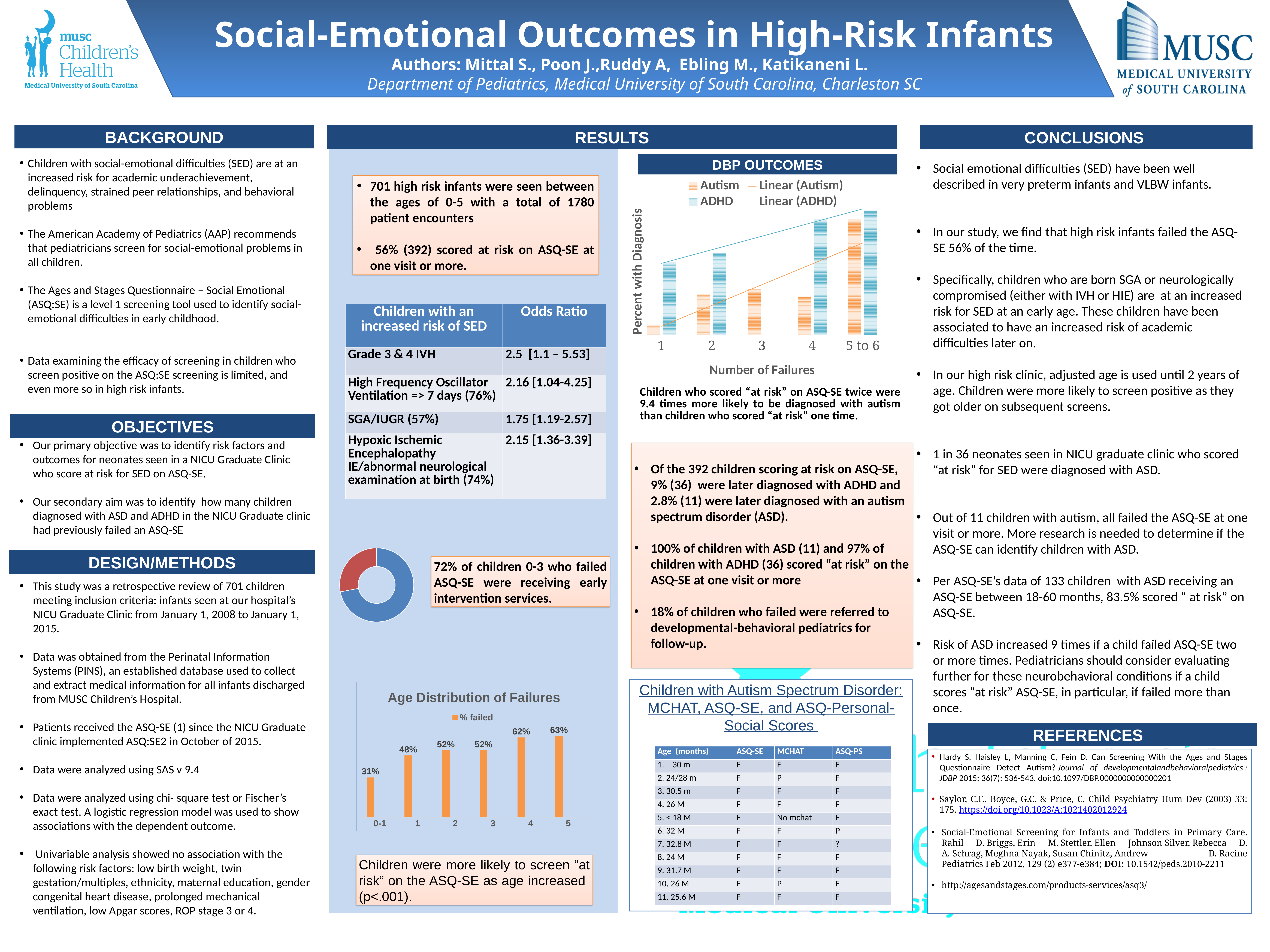
In the DBP Outcomes chart, how many entries does the legend list? 4 In the Age Distribution of Failures chart, which age category has the lowest percentage failed? 0-1 In the Age Distribution of Failures chart, what is the difference between the values for age 5 and age 0-1? 32% In the Age Distribution of Failures chart, do the values generally rise or fall as age increases? rise In the DBP Outcomes chart, at 1 failure, which is larger: the Autism bar or the ADHD bar? ADHD In the DBP Outcomes chart, which number-of-failures category has the highest Autism bar? 5 to 6 In the Age Distribution of Failures chart, what percentage failed in the 0-1 category? 31% In the Age Distribution of Failures chart, how many age categories are shown? 6 In the Age Distribution of Failures chart, what is the value for age 4? 62% In the Age Distribution of Failures chart, which age category has the highest percentage failed? 5 What kind of chart is the Age Distribution of Failures chart? bar chart What is the x-axis title of the DBP Outcomes chart? Number of Failures